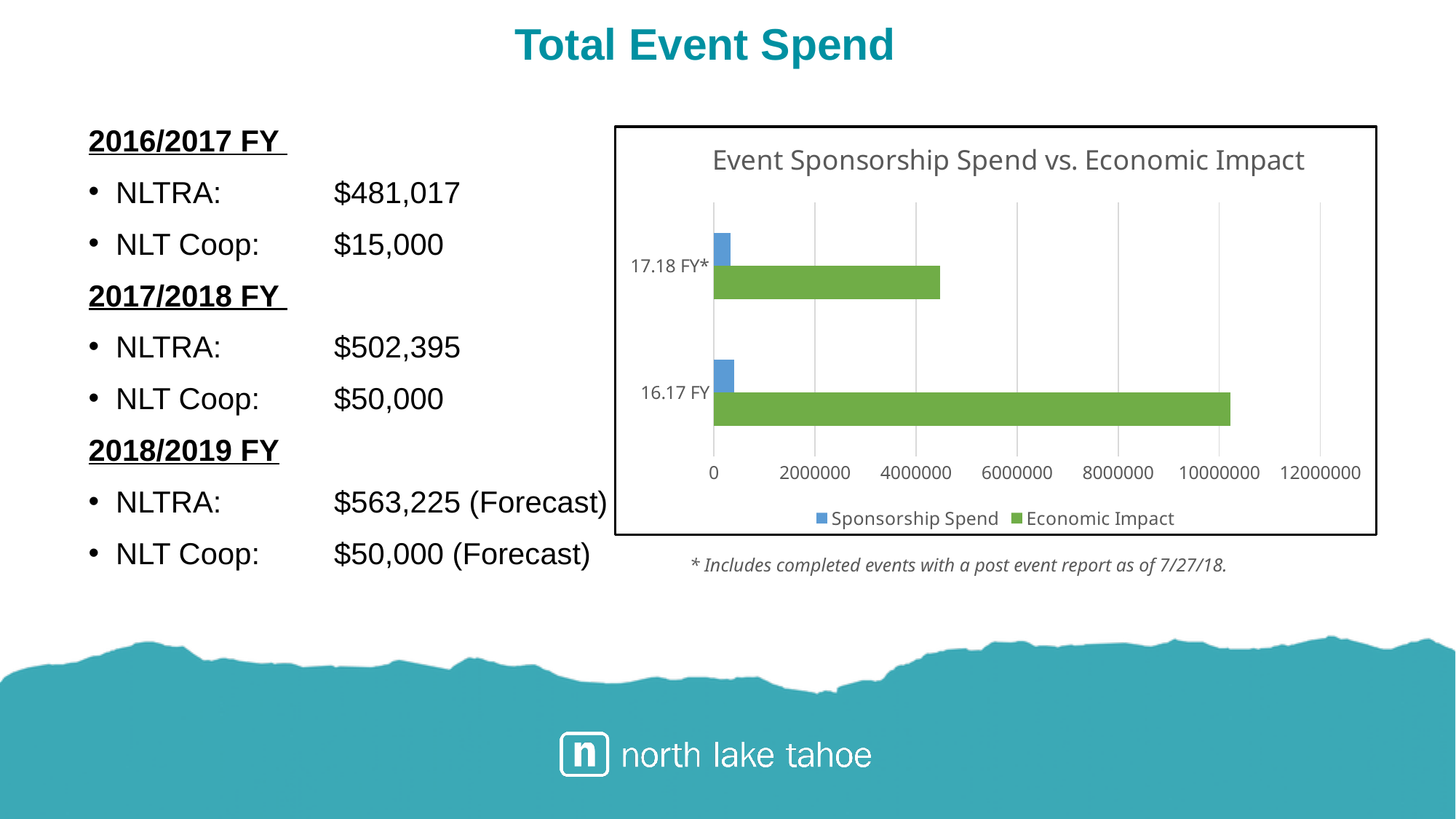
What kind of chart is shown on the slide? Bar chart What is the highest value shown on the chart's horizontal axis? 12000000 Is the Economic Impact value for 17.18 FY* greater or less than 6000000? less Which series is shown in green on the chart? Economic Impact What is the title of the chart? Event Sponsorship Spend vs. Economic Impact Which fiscal year has the lower Economic Impact value? 17.18 FY* Is the Economic Impact value for 16.17 FY greater or less than 8000000? greater How many fiscal year categories are plotted on the chart? 2 Which fiscal year has the higher Economic Impact value? 16.17 FY How many series does the chart legend list? 2 For 17.18 FY*, which is larger: Sponsorship Spend or Economic Impact? Economic Impact Is the Sponsorship Spend value for 16.17 FY greater or less than 2000000? less